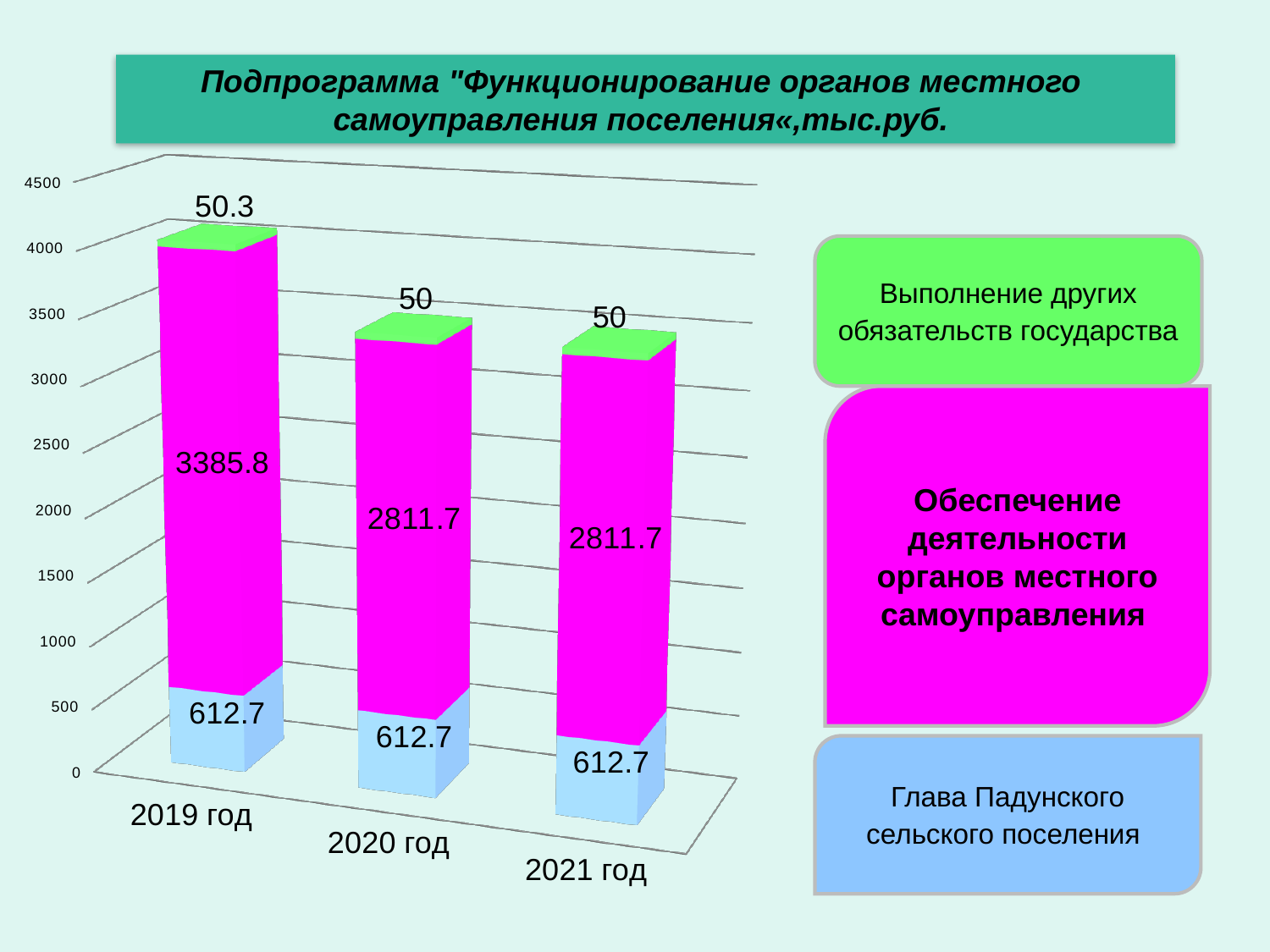
What is the value for "Глава Падунского сельского поселения" in 2021 год? 612.7 How many series does the legend list? 3 What is the total of the stacked bar for 2021 год? 3474.4 What is the value for "Обеспечение деятельности органов местного самоуправления" in 2020 год? 2811.7 In which year is the value for "Обеспечение деятельности органов местного самоуправления" highest? 2019 год What is the total of the stacked bar for 2019 год? 4048.8 What kind of chart is shown on the slide? Stacked bar chart How many years are shown on the x axis? 3 What is the value for "Выполнение других обязательств государства" in 2019 год? 50.3 What is the value for "Обеспечение деятельности органов местного самоуправления" in 2019 год? 3385.8 What is the difference between the "Обеспечение деятельности органов местного самоуправления" values for 2019 год and 2020 год? 574.1 Which is larger: the "Выполнение других обязательств государства" value in 2019 год or in 2020 год? 2019 год